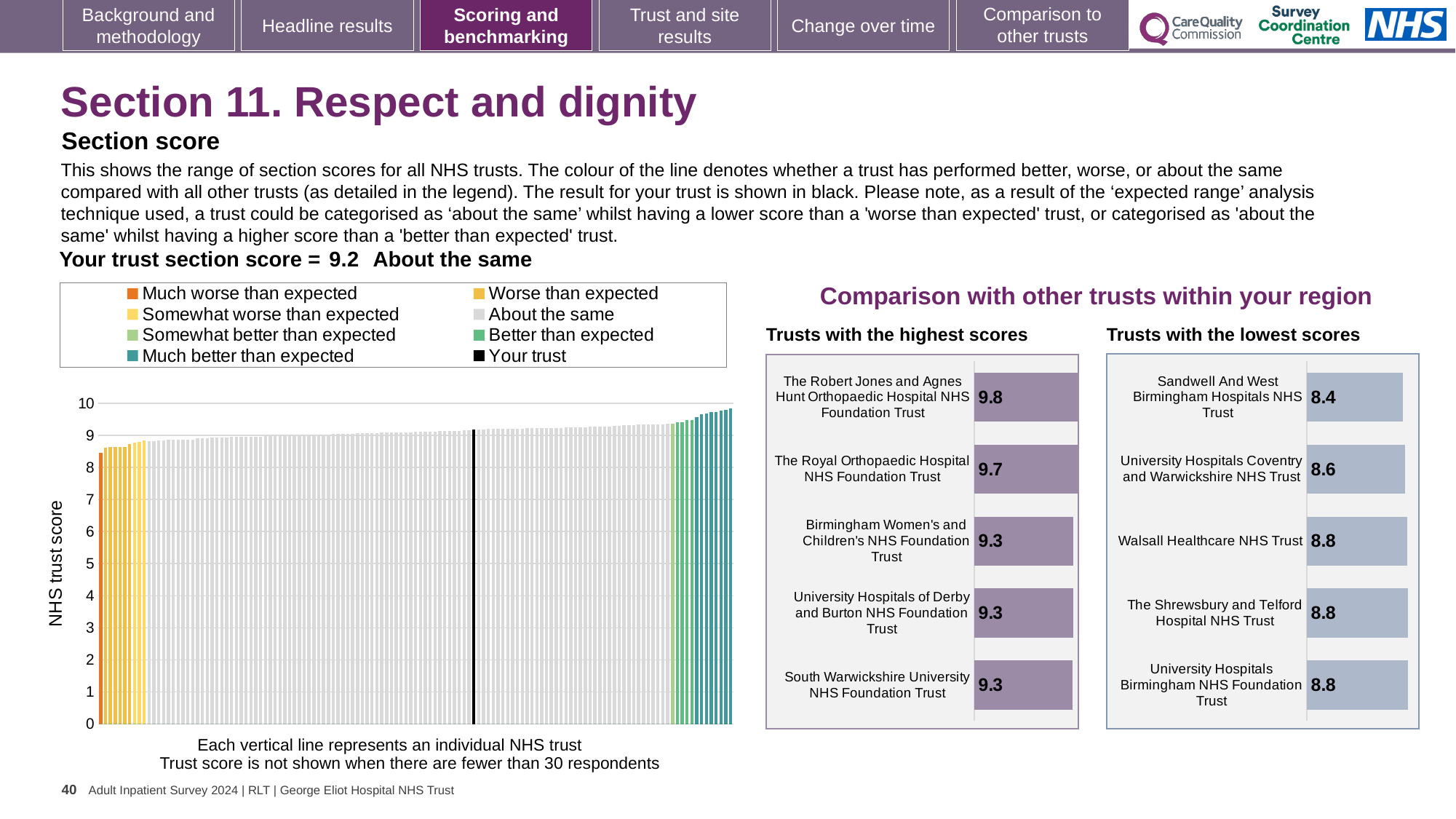
How many entries does the legend of the 'NHS trust score' chart on the left list? 8 In the 'Trusts with the highest scores' chart, which trust has the highest score? The Robert Jones and Agnes Hunt Orthopaedic Hospital NHS Foundation Trust In the 'Trusts with the highest scores' chart, what is the score for The Royal Orthopaedic Hospital NHS Foundation Trust? 9.7 In the 'Trusts with the lowest scores' chart, which trust has the lowest score? Sandwell And West Birmingham Hospitals NHS Trust In the 'Trusts with the lowest scores' chart, what is the score for University Hospitals Coventry and Warwickshire NHS Trust? 8.6 In the 'Trusts with the lowest scores' chart, what is the score for Sandwell And West Birmingham Hospitals NHS Trust? 8.4 Which is larger: the score for The Royal Orthopaedic Hospital NHS Foundation Trust in the 'Trusts with the highest scores' chart, or the score for University Hospitals Birmingham NHS Foundation Trust in the 'Trusts with the lowest scores' chart? The Royal Orthopaedic Hospital NHS Foundation Trust In the 'Trusts with the highest scores' chart, what is the score for The Robert Jones and Agnes Hunt Orthopaedic Hospital NHS Foundation Trust? 9.8 In the 'Trusts with the highest scores' chart, what is the difference between the score for The Robert Jones and Agnes Hunt Orthopaedic Hospital NHS Foundation Trust and the score for South Warwickshire University NHS Foundation Trust? 0.5 In the 'Trusts with the lowest scores' chart, what is the difference between the score for Walsall Healthcare NHS Trust and the score for Sandwell And West Birmingham Hospitals NHS Trust? 0.4 In the 'NHS trust score' chart on the left, do the bar heights rise or fall from left to right? rise How many trusts are shown in the 'Trusts with the lowest scores' chart? 5